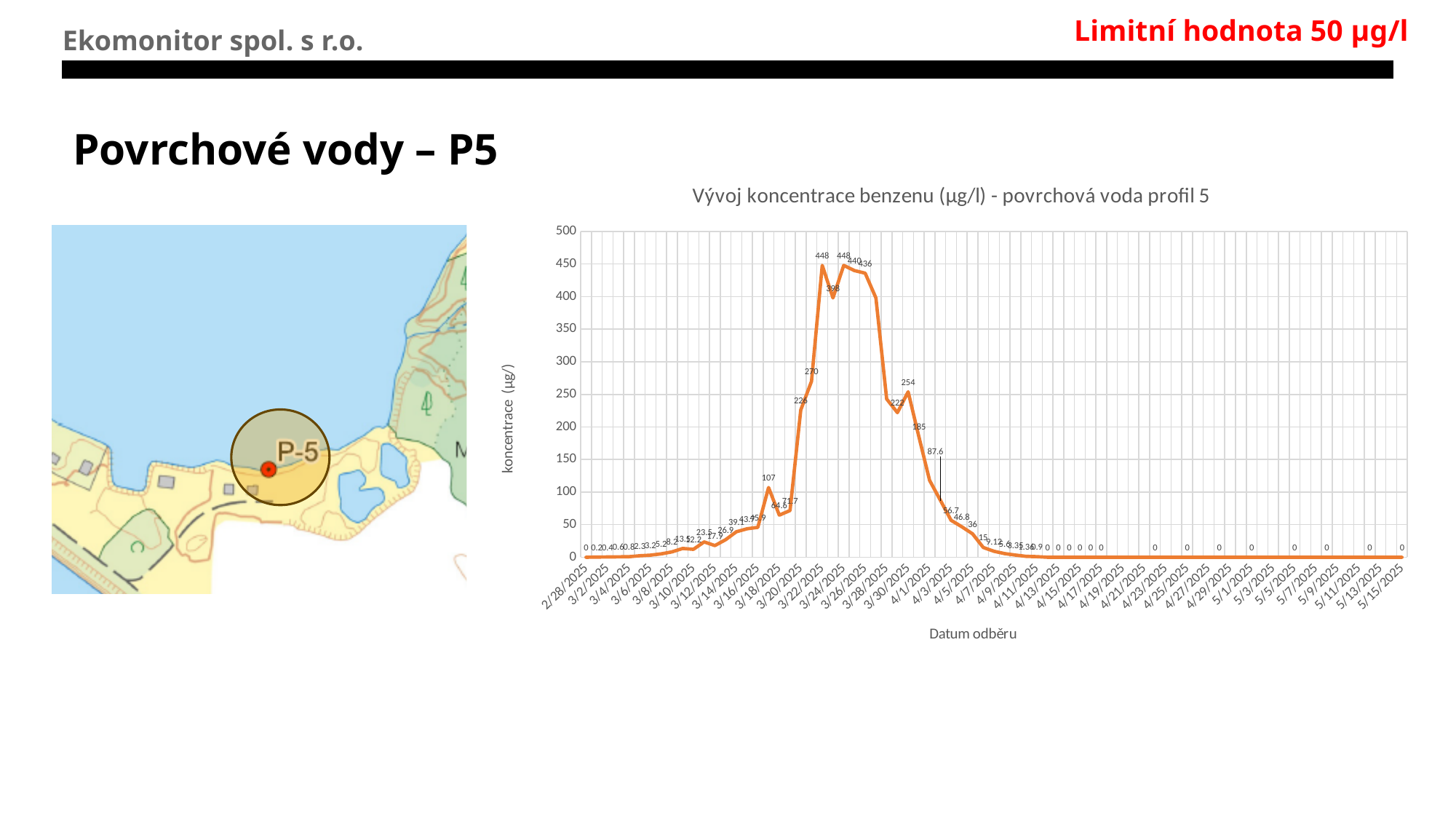
What is the highest benzene concentration value labelled on the chart? 448 What is the difference between the labelled values 448 and 398 at the peak of the chart? 50 What is the title of the chart? Vývoj koncentrace benzenu (µg/l) - povrchová voda profil 5 Is the value for 3/10/2025 greater or less than 50? less What is the label of the x axis of the chart? Datum odběru What type of chart is shown on the slide? line chart What is the lowest value labelled on the chart? 0 What is the concentration value on 5/15/2025? 0 Is the value for 3/24/2025 greater or less than 300? greater Is the value for 4/15/2025 greater or less than 50? less What is the concentration value on 2/28/2025? 0 Do the values rise or fall between 4/1/2025 and 4/9/2025? fall